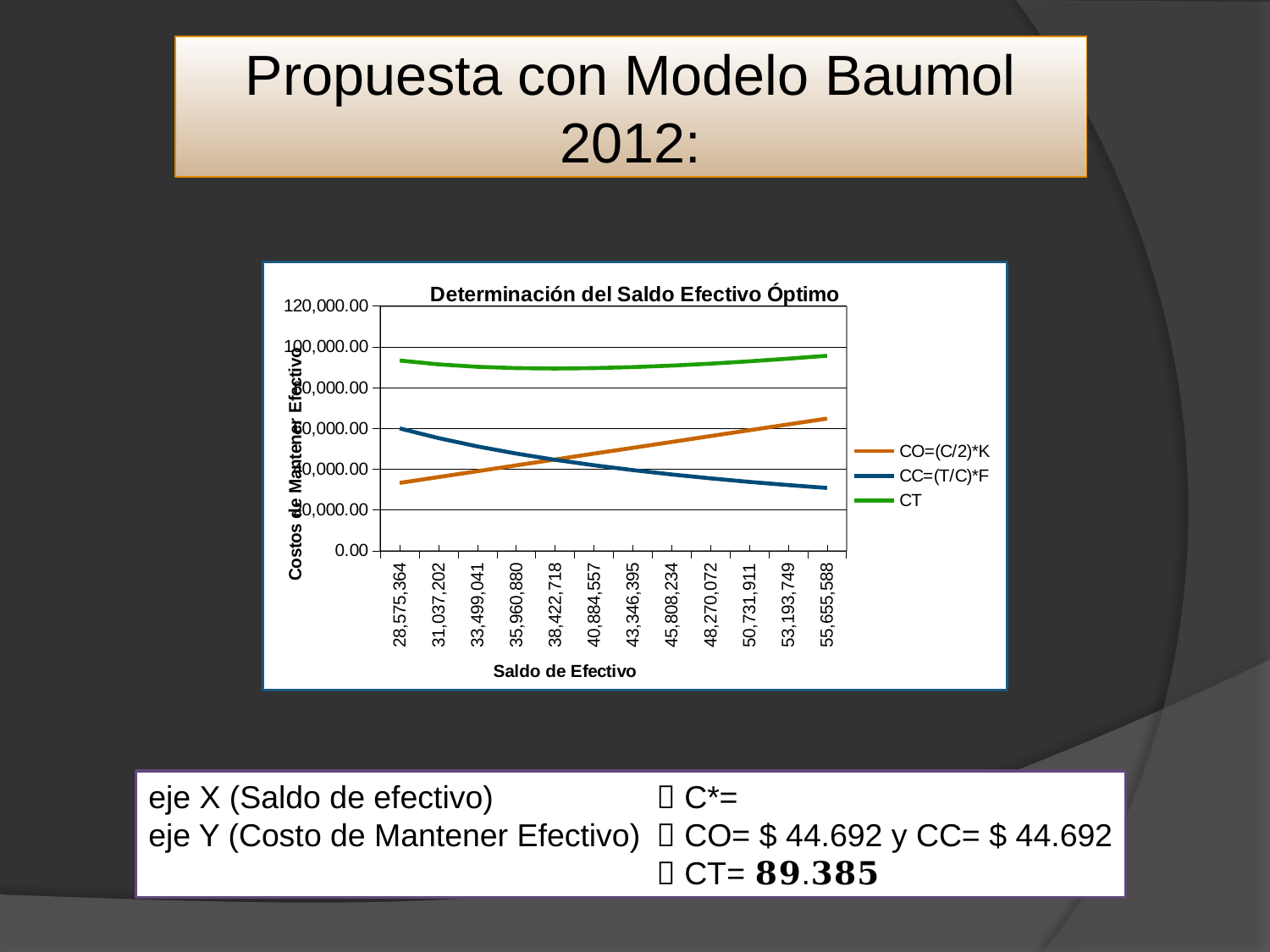
At a Saldo de Efectivo of 28,575,364, which is larger: CO=(C/2)*K or CC=(T/C)*F? CC=(T/C)*F How many points are plotted along the x axis of the chart? 12 Is the value of CO=(C/2)*K at 28,575,364 greater or less than 40,000.00? less Does the CC=(T/C)*F series rise or fall as the Saldo de Efectivo increases? fall What kind of chart is shown on the slide? line chart What is the label of the x axis of the chart? Saldo de Efectivo Is the value of CT at 55,655,588 greater or less than 80,000.00? greater What is the title of the chart? Determinación del Saldo Efectivo Óptimo At a Saldo de Efectivo of 55,655,588, which is larger: CO=(C/2)*K or CC=(T/C)*F? CO=(C/2)*K How many series does the chart legend list? 3 Which series has the highest values across the whole chart? CT Does the CO=(C/2)*K series rise or fall as the Saldo de Efectivo increases? rise